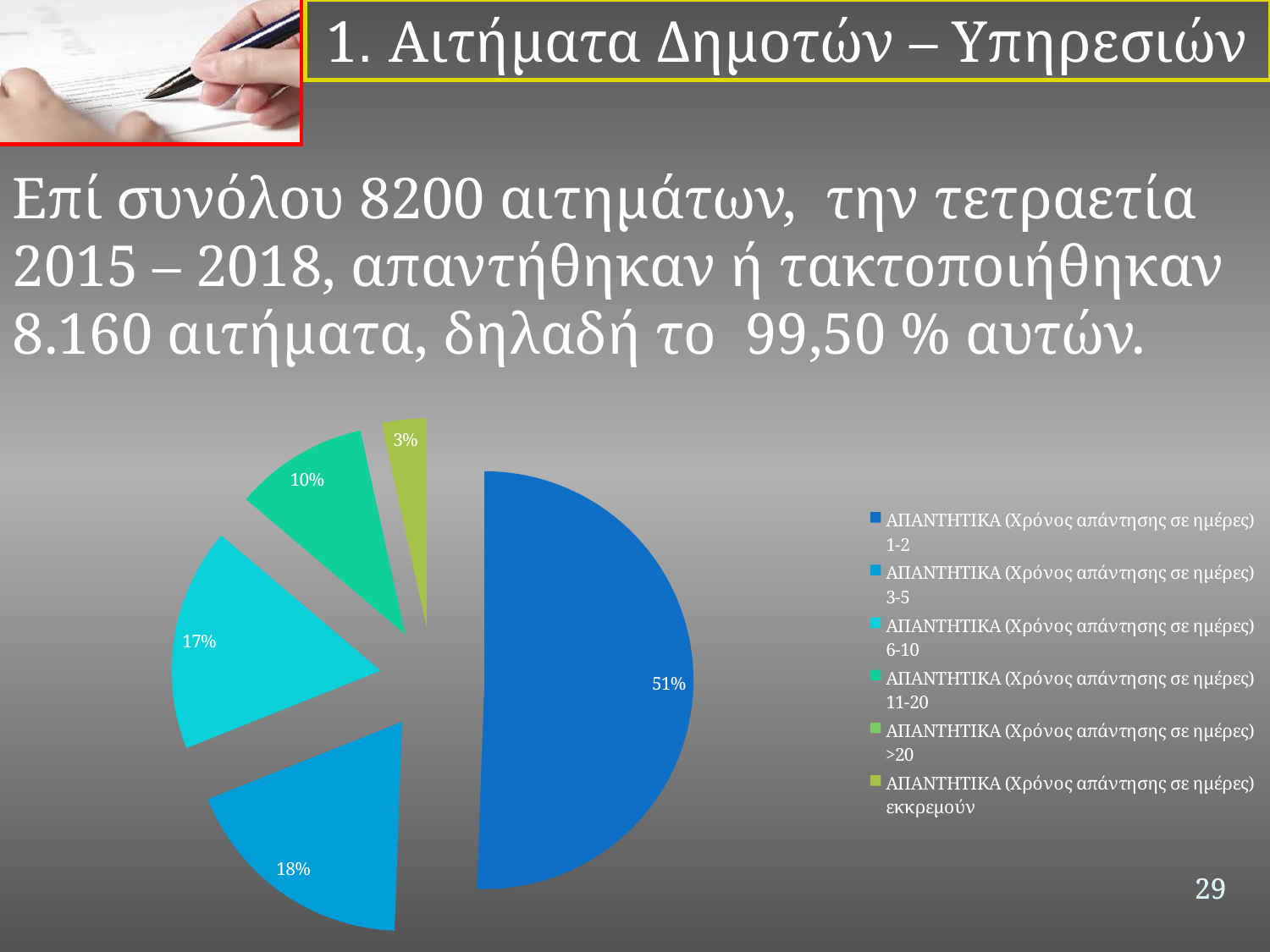
Which category has the largest slice in the pie chart? ΑΠΑΝΤΗΤΙΚΑ (Χρόνος απάντησης σε ημέρες) 1-2 What is the difference in percentage points between the 6-10 days slice and the 11-20 days slice? 7 percentage points What percentage of the pie chart corresponds to ΑΠΑΝΤΗΤΙΚΑ (Χρόνος απάντησης σε ημέρες) 6-10? 17% What is the difference in percentage points between the 1-2 days slice and the 3-5 days slice? 33 percentage points What percentage of the pie chart corresponds to ΑΠΑΝΤΗΤΙΚΑ (Χρόνος απάντησης σε ημέρες) 1-2? 51% What percentage of the pie chart corresponds to ΑΠΑΝΤΗΤΙΚΑ (Χρόνος απάντησης σε ημέρες) 3-5? 18% What percentage of the pie chart corresponds to ΑΠΑΝΤΗΤΙΚΑ (Χρόνος απάντησης σε ημέρες) 11-20? 10% Which slice is larger: the 3-5 days slice or the 6-10 days slice? 3-5 days (18%) How many entries does the legend of the pie chart list? 6 What type of chart is shown on the slide? Pie chart What colour is the largest slice (51%) of the pie chart? Blue